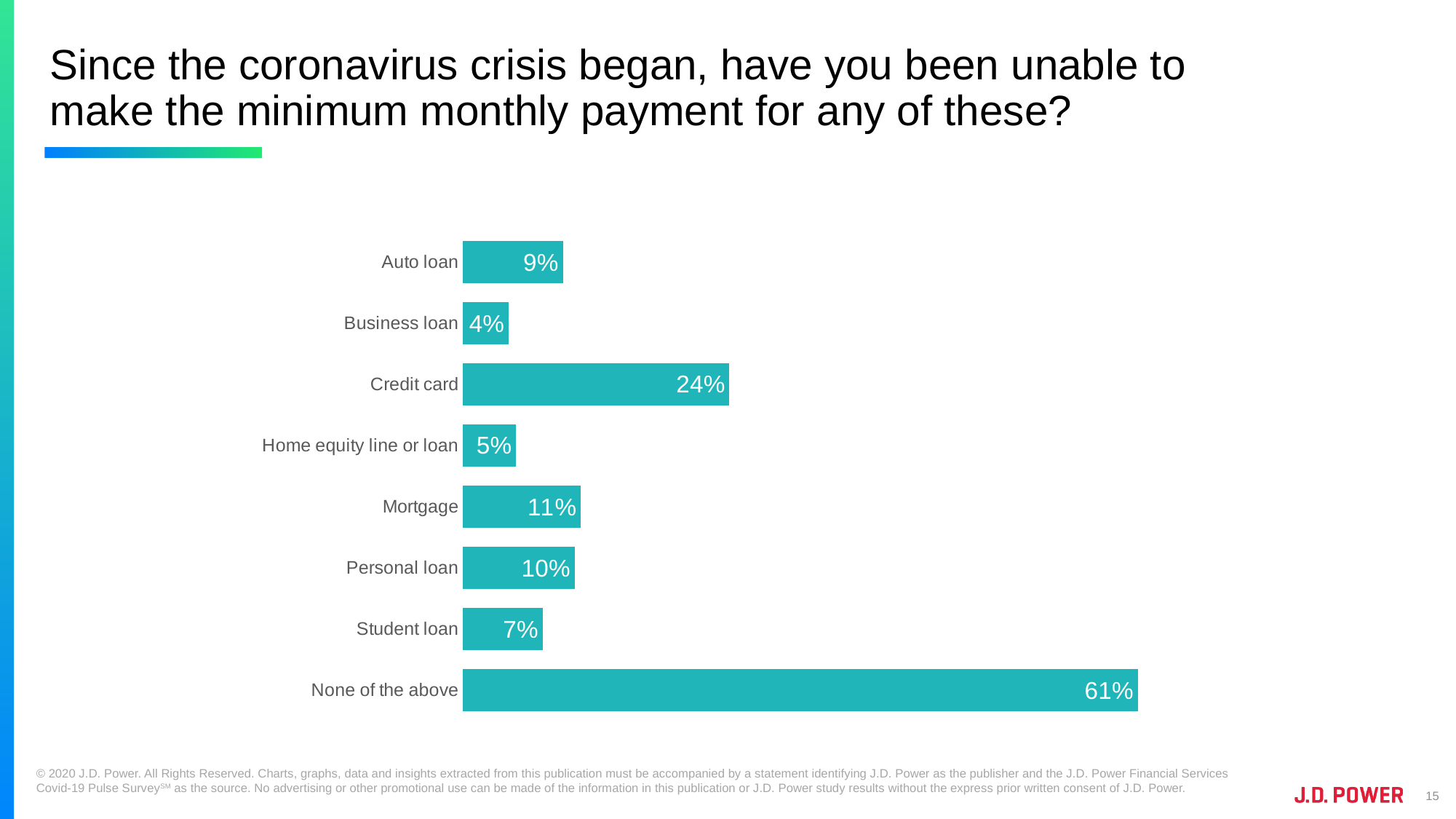
What is the value shown for None of the above? 61% Among the loan and credit categories (excluding None of the above), which has the highest value? Credit card What percentage of respondents were unable to make the minimum monthly payment on a credit card? 24% Which category has the lowest value? Business loan What is the value shown for Business loan? 4% Which category has the highest value? None of the above What is the difference between the values for Student loan and Home equity line or loan? 2% How many categories are shown in the chart? 8 What is the value shown for Mortgage? 11% What is the difference between the values for Credit card and Auto loan? 15% Which is larger, the value for Mortgage or the value for Personal loan? Mortgage What kind of chart is shown on the slide? Bar chart